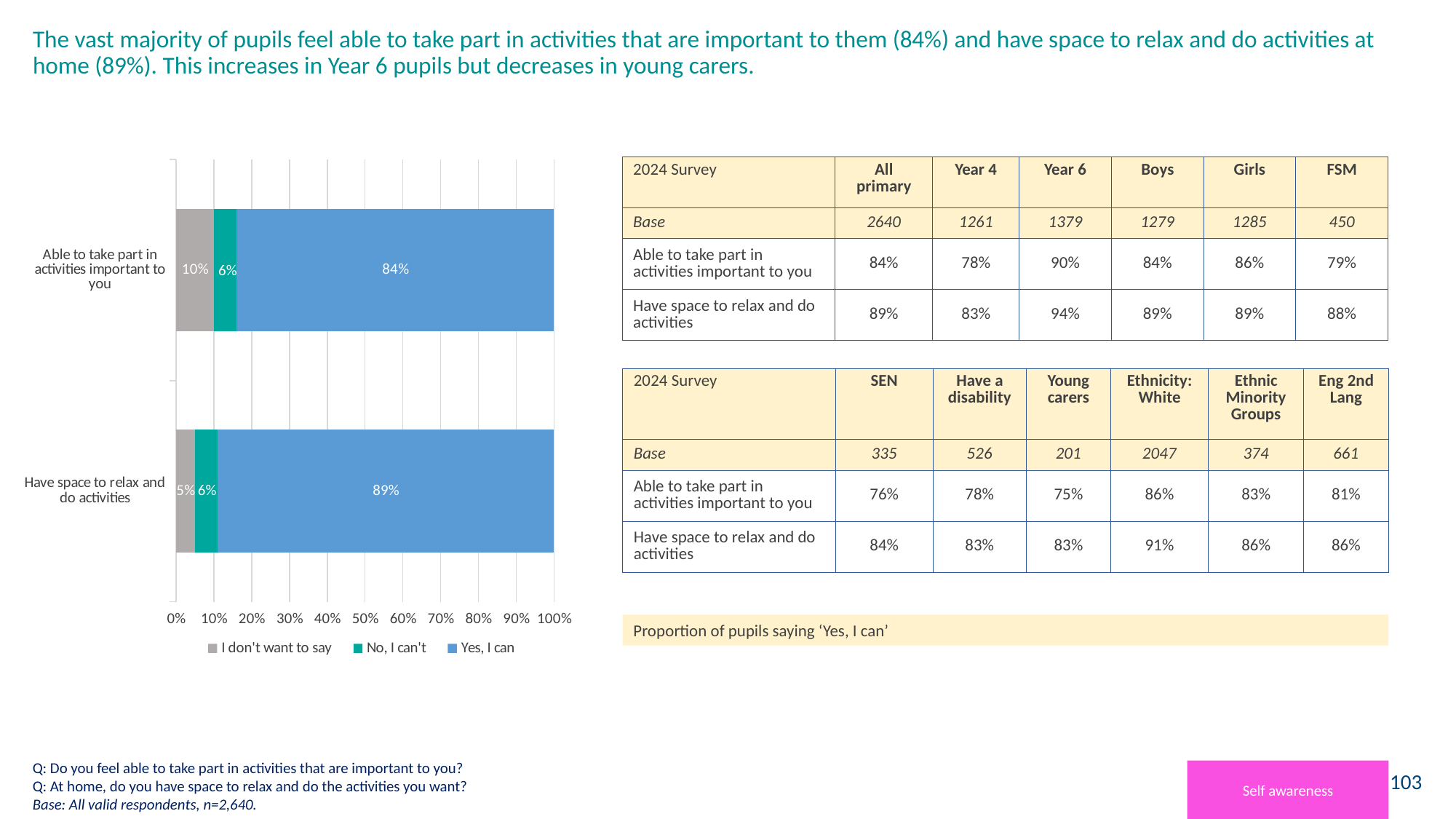
What percentage of pupils said 'I don't want to say' for 'Able to take part in activities important to you'? 10% What percentage of pupils said 'I don't want to say' for 'Have space to relax and do activities'? 5% What percentage of pupils said 'Yes, I can' for 'Have space to relax and do activities'? 89% What percentage of pupils said 'No, I can't' for 'Have space to relax and do activities'? 6% What percentage of pupils said 'Yes, I can' for 'Able to take part in activities important to you'? 84% How many series does the legend list? 3 What kind of chart is shown on the slide? Stacked bar chart What is the difference between the 'Yes, I can' percentages for 'Have space to relax and do activities' and 'Able to take part in activities important to you'? 5% How many categories are shown on the chart? 2 What colour represents the 'Yes, I can' series in the chart? Blue Which category has the higher 'Yes, I can' percentage? Have space to relax and do activities Is the 'I don't want to say' value larger for 'Able to take part in activities important to you' or for 'Have space to relax and do activities'? Able to take part in activities important to you